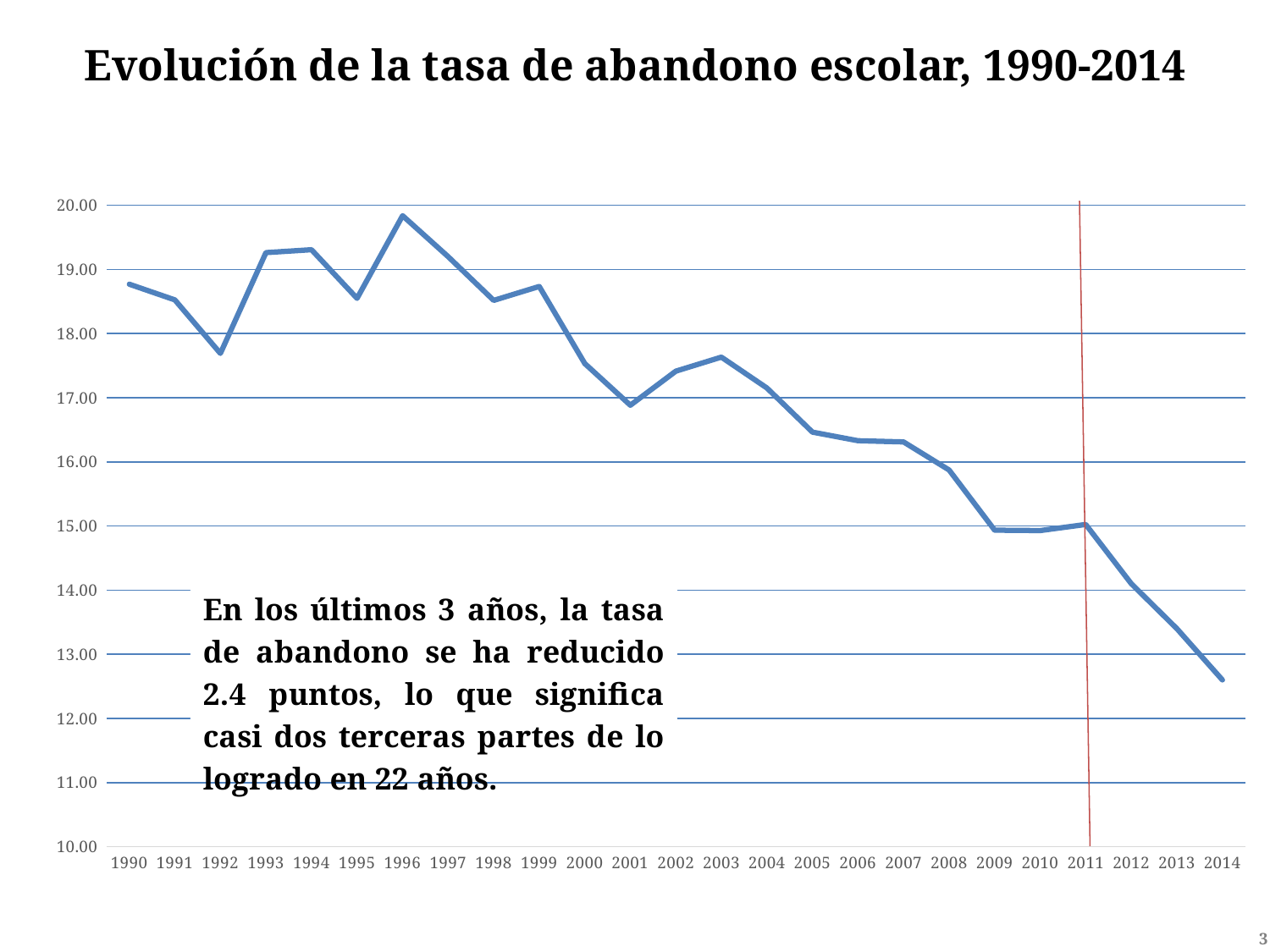
Is the value for 1992 greater or less than 18.00? less Is the value for 2005 greater or less than 17.00? less How many years are plotted along the x axis? 25 In which year is the school dropout rate lowest? 2014 What is the title of the chart? Evolución de la tasa de abandono escolar, 1990-2014 Which year has the larger value, 1990 or 2010? 1990 Is the value for 2014 greater or less than 13.00? less Overall, does the dropout rate rise or fall from 1990 to 2014? fall In which year is the school dropout rate highest? 1996 Which year has the larger value, 2003 or 2005? 2003 What kind of chart is shown on the slide? line chart